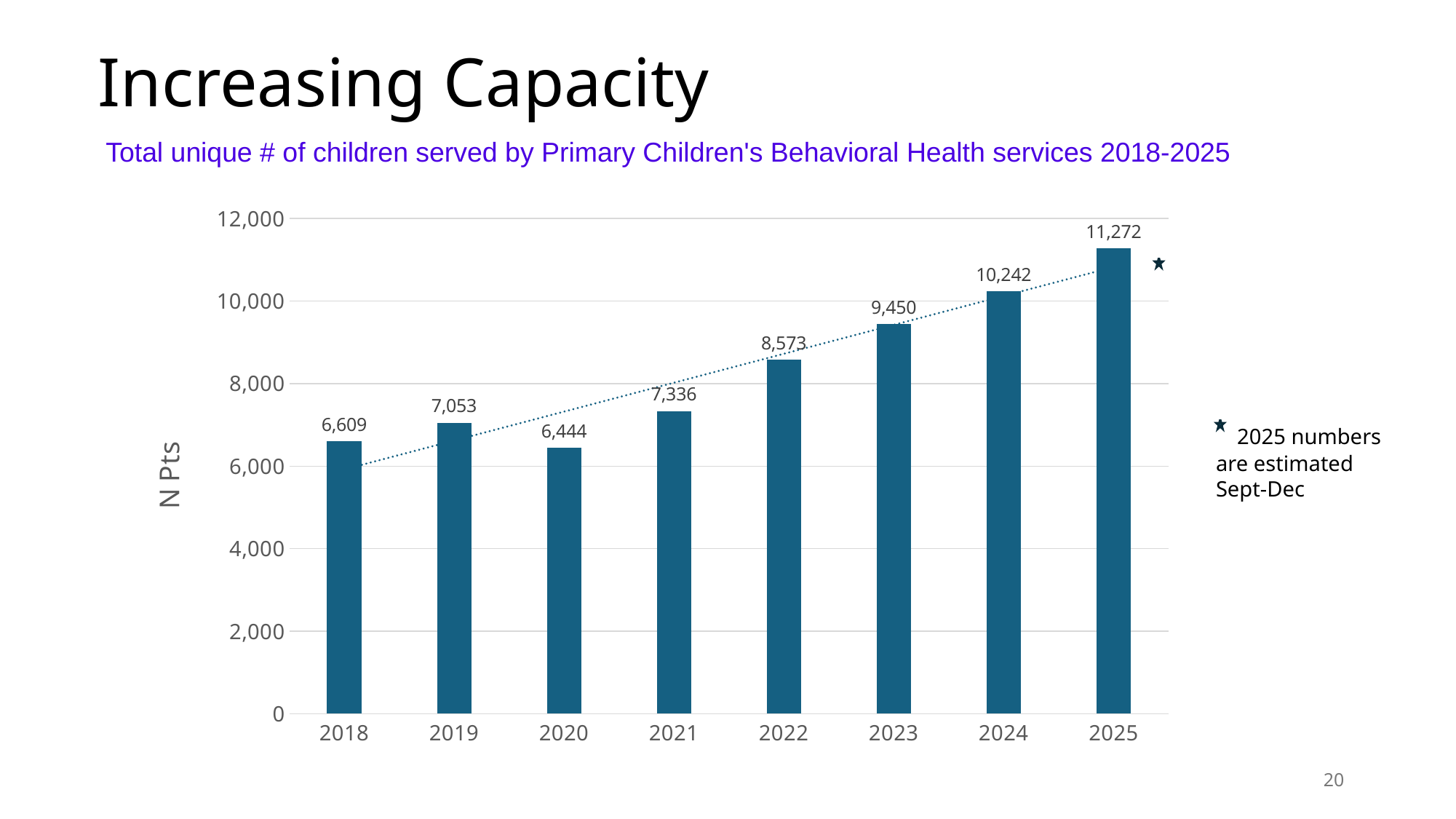
Which year has the lowest value? 2020 Which year has the highest value? 2025 What is the value for 2022? 8,573 Is the value for 2024 greater or less than 10,000? greater What is the difference between the values for 2019 and 2020? 609 Which is larger, the value for 2021 or the value for 2023? 2023 What is the value for 2018? 6,609 How many years are shown on the x axis? 8 What kind of chart is this? bar chart What is the value for 2025? 11,272 What is the difference between the values for 2025 and 2024? 1,030 What is the label on the y axis? N Pts